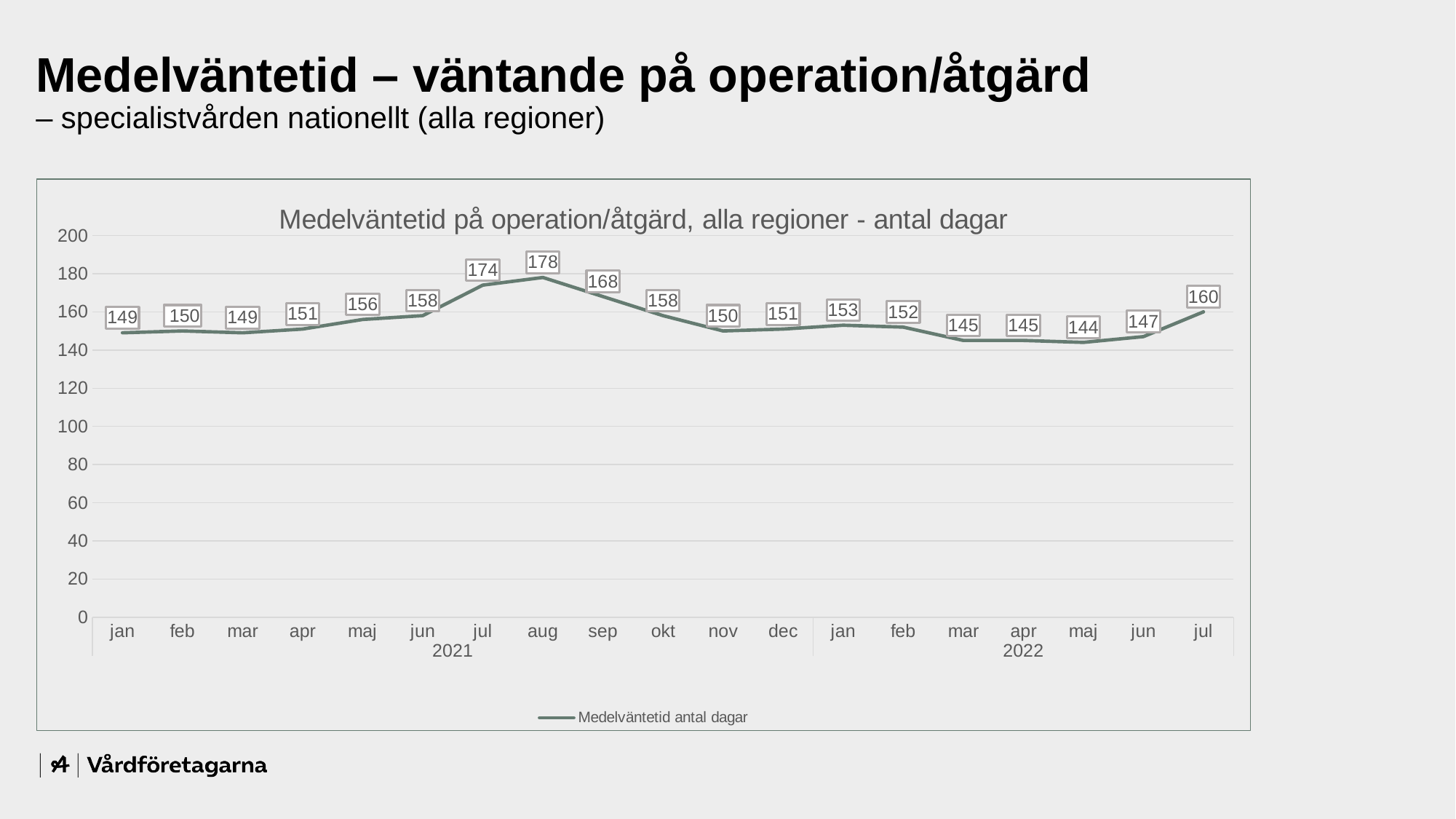
What is the value for jul 2022? 160 What is the value for aug 2021? 178 Which month has the highest value? aug 2021 How many data points are plotted on the line? 19 Which month has the lowest value? maj 2022 What type of chart is shown on the slide? line chart What is the value for maj 2022? 144 How many series does the legend list? 1 What is the difference between the values for aug 2021 and sep 2021? 10 Is the value for jun 2021 greater or less than 140? greater What is the title of the chart? Medelväntetid på operation/åtgärd, alla regioner - antal dagar Which is larger, the value for jul 2021 or the value for jul 2022? jul 2021